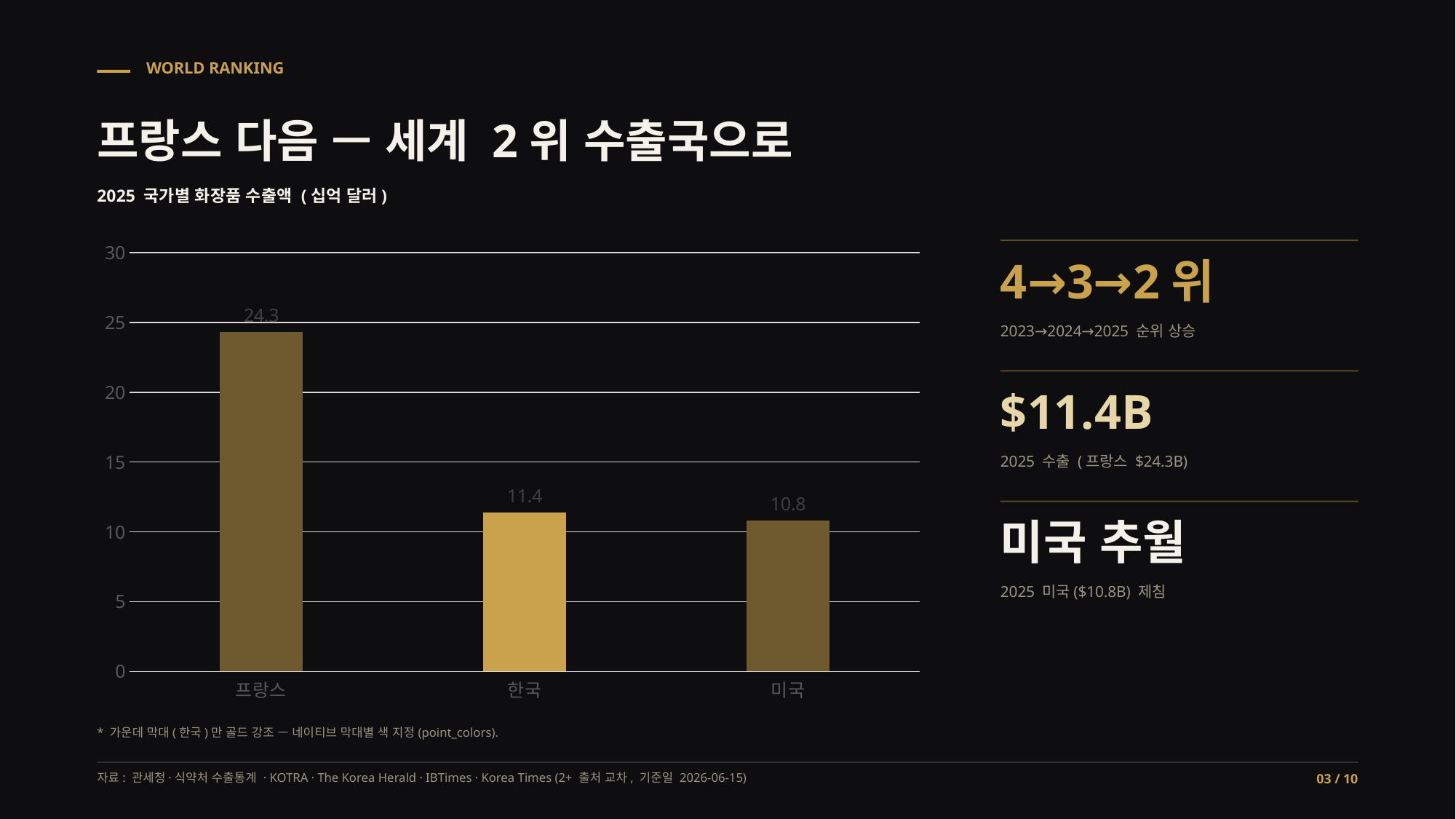
What is the value for 한국? 11.4 What is the value for 미국? 10.8 Which country has the highest value? 프랑스 What kind of chart is shown on the slide? bar chart Which is larger, the value for 프랑스 or the value for 미국? 프랑스 Which bar is highlighted in gold? 한국 Which country has the lowest value? 미국 What is the difference between the values for 프랑스 and 한국? 12.9 What is the difference between the values for 한국 and 미국? 0.6 Is the value for 프랑스 greater or less than 20? greater What is the value for 프랑스? 24.3 How many countries are shown in the chart? 3